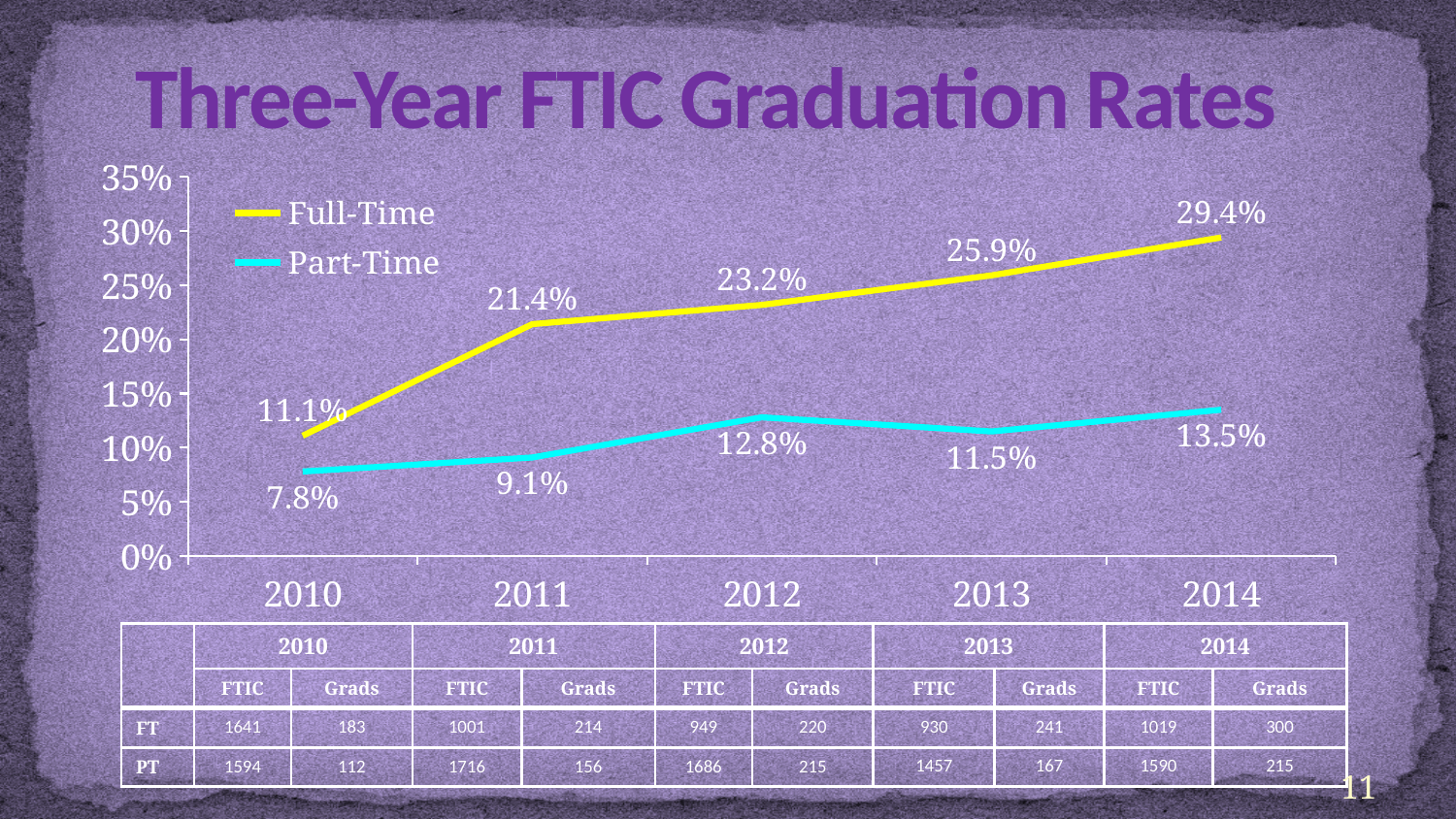
How many series does the legend list? 2 In which year is the Part-Time graduation rate lowest? 2010 How many years are shown on the x axis? 5 What is the Part-Time graduation rate for 2010? 7.8% What is the Part-Time graduation rate for 2013? 11.5% What is the difference between the Full-Time and Part-Time graduation rates in 2012? 10.4% What is the Full-Time graduation rate for 2011? 21.4% In which year is the Full-Time graduation rate highest? 2014 Does the Full-Time graduation rate rise or fall from 2010 to 2014? Rise Which series has the higher graduation rate in 2013, Full-Time or Part-Time? Full-Time What kind of chart is shown on the slide? Line chart What is the Full-Time graduation rate for 2014? 29.4%